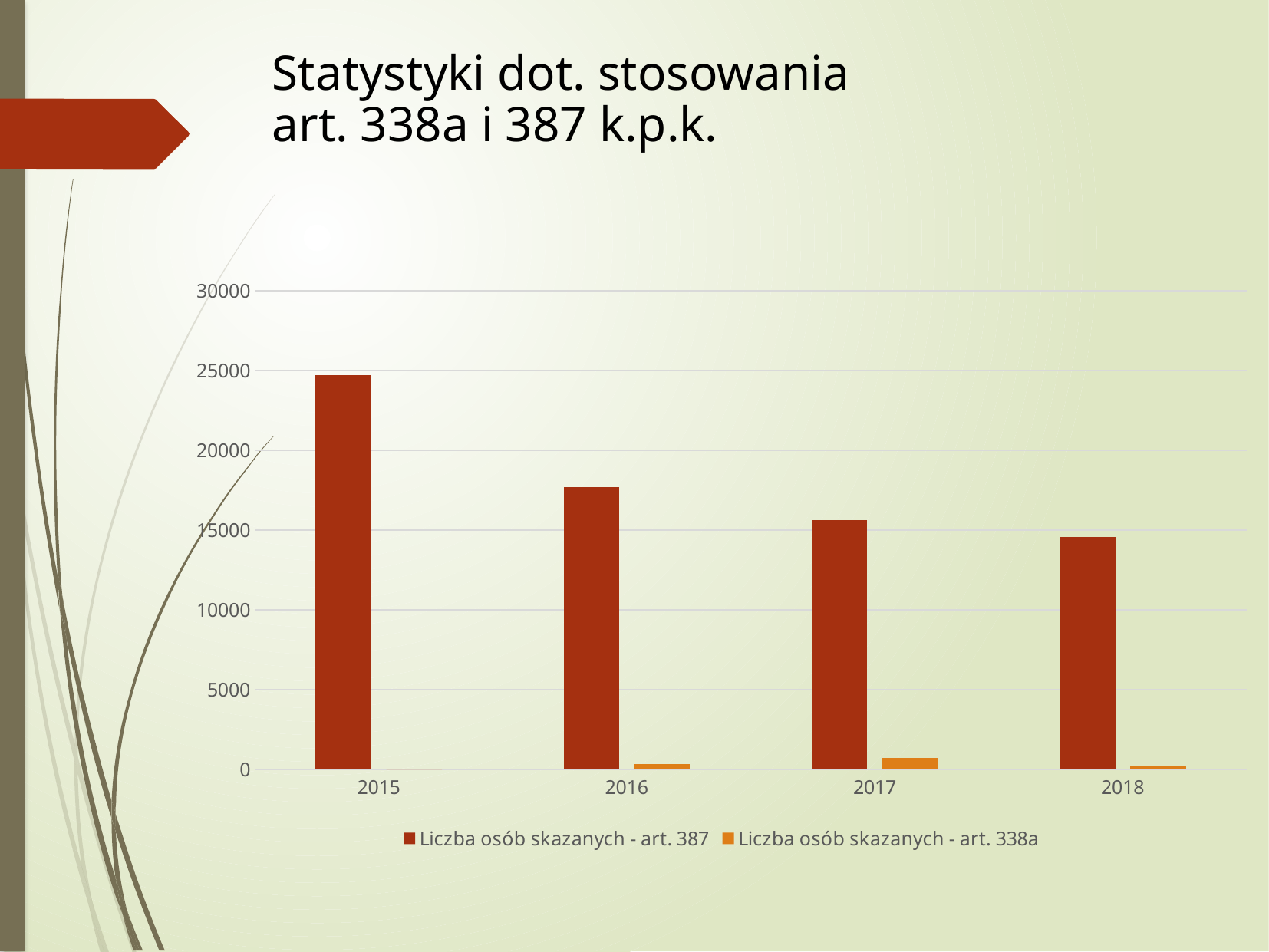
Which year has the highest value for 'Liczba osób skazanych - art. 387'? 2015 Is the value for 'Liczba osób skazanych - art. 387' in 2016 greater or less than 15000? greater Is the value for 'Liczba osób skazanych - art. 387' in 2018 greater or less than 15000? less Which year has the highest value for 'Liczba osób skazanych - art. 338a'? 2017 How many series does the chart legend list? 2 Is the value for 'Liczba osób skazanych - art. 387' in 2015 greater or less than 20000? greater How many years are shown on the x axis of the chart? 4 What is the title of the slide containing the chart? Statystyki dot. stosowania art. 338a i 387 k.p.k. Which year has the lowest value for 'Liczba osób skazanych - art. 387'? 2018 Which is larger in 2017: 'Liczba osób skazanych - art. 387' or 'Liczba osób skazanych - art. 338a'? Liczba osób skazanych - art. 387 Do the values for 'Liczba osób skazanych - art. 387' rise or fall from 2015 to 2018? fall What kind of chart is shown on the slide? bar chart